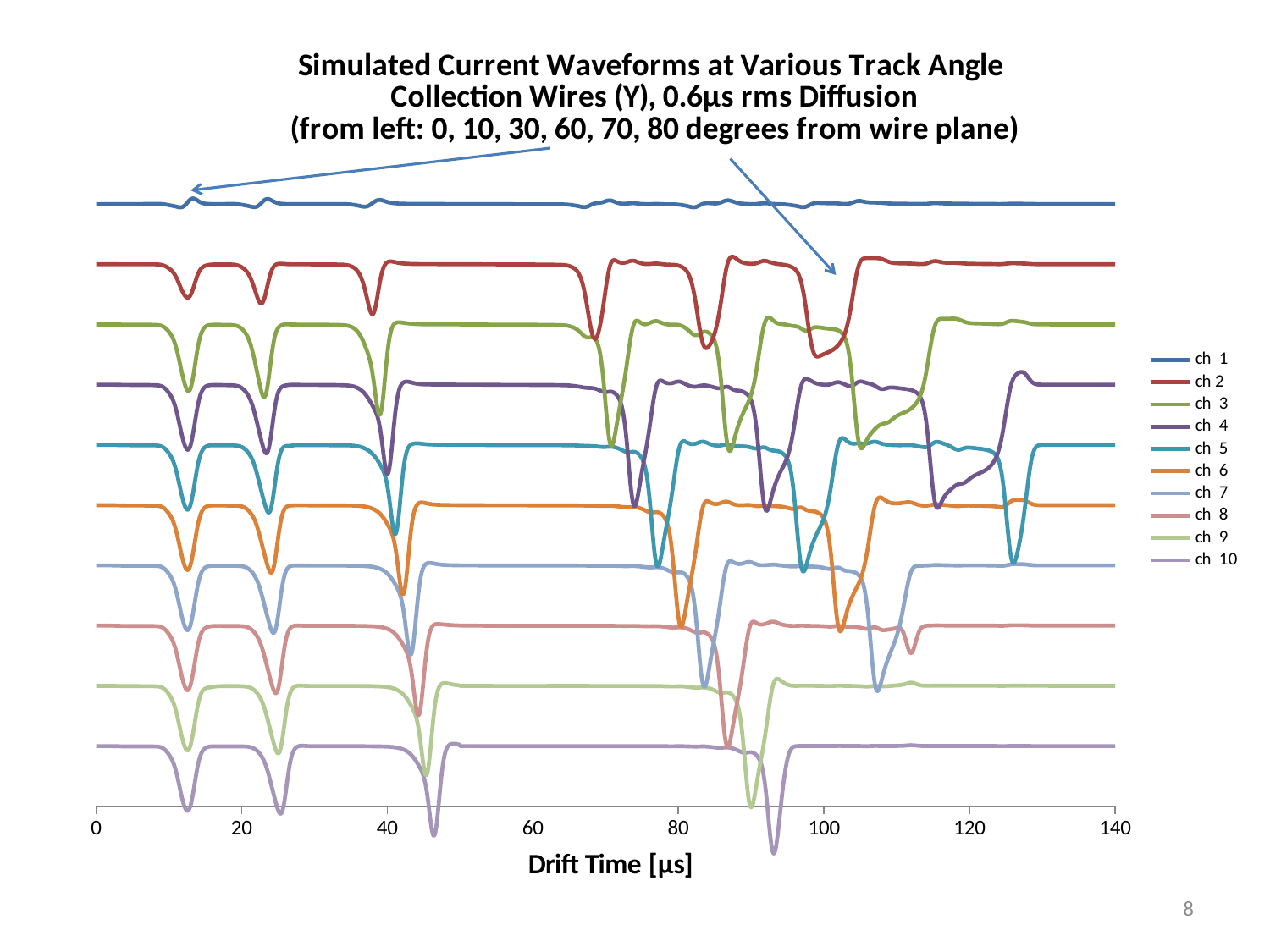
Which series is plotted as the bottommost line on the chart? ch 10 What rms diffusion value is stated in the chart title? 0.6μs What is the label of the x axis? Drift Time [μs] Does the last (rightmost) dip of ch 10 occur at a drift time greater or less than 80 μs? greater Which series is plotted as the topmost line on the chart? ch 1 What is the largest value shown on the x axis? 140 How many series does the legend list? 10 Does the last dip of ch 2 occur at a drift time greater or less than 120 μs? less What kind of chart is shown on the slide? line chart Does the first dip of ch 10 occur at a drift time greater or less than 20 μs? less How many track angles (in degrees from wire plane) does the chart title list? 6